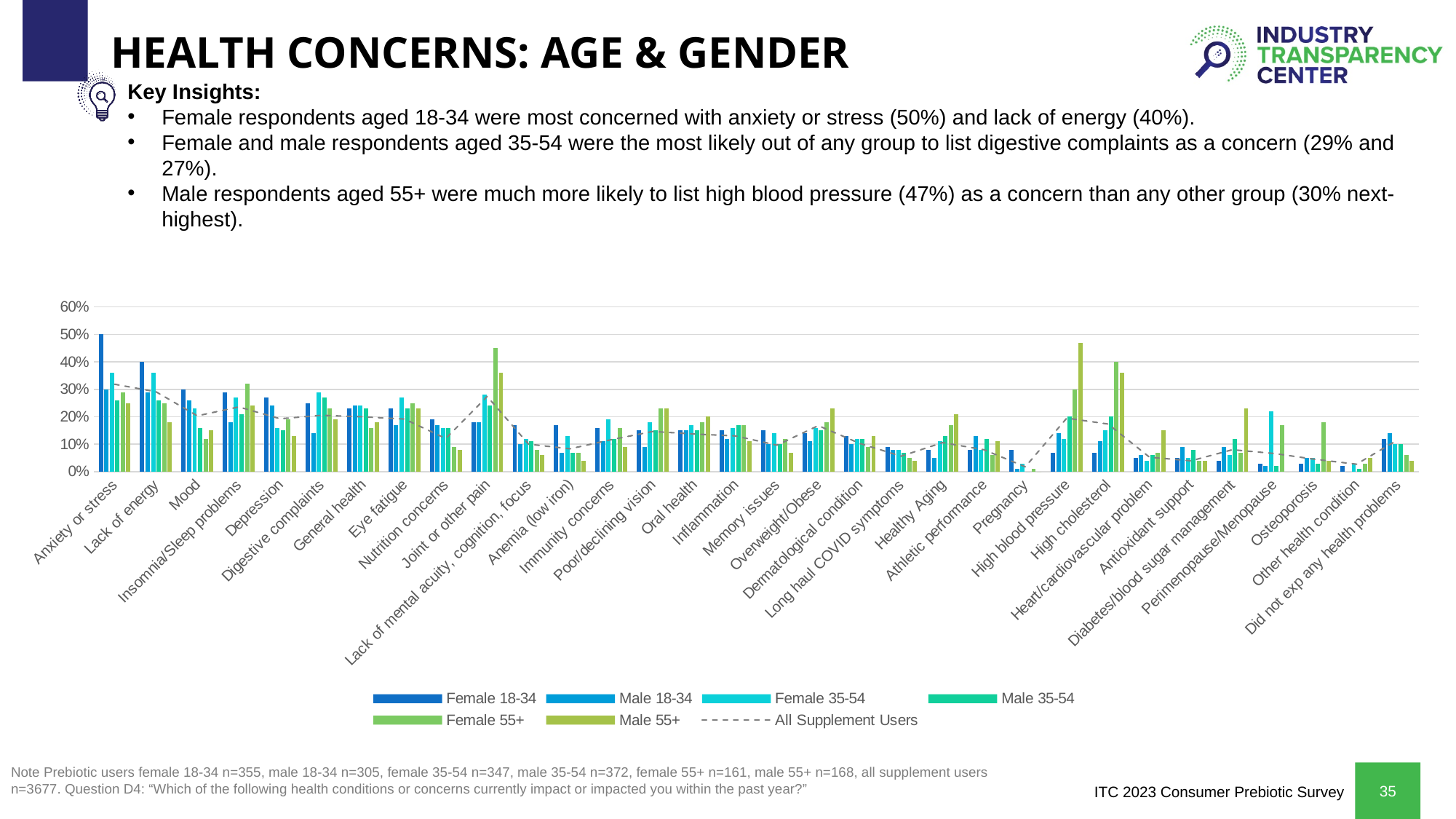
Which series has the highest bar for High blood pressure? Male 55+ What is the difference between the Female 35-54 (29%) and Male 35-54 (27%) values for Digestive complaints? 2 percentage points Which series has the highest bar for Anxiety or stress? Female 18-34 What kind of chart is shown on the slide? combination bar and line chart What is the value for Female 18-34 for Anxiety or stress? 50% How many series does the legend list? 7 What is the value for Female 18-34 for Lack of energy? 40% Which series has the highest bar for Joint or other pain? Female 55+ What is the value for Male 55+ for High blood pressure? 47% Is the value for Male 55+ for Pregnancy greater or less than 10%? less Is the value for Female 55+ for High cholesterol greater or less than 30%? greater How many health concern categories are shown on the x axis? 32